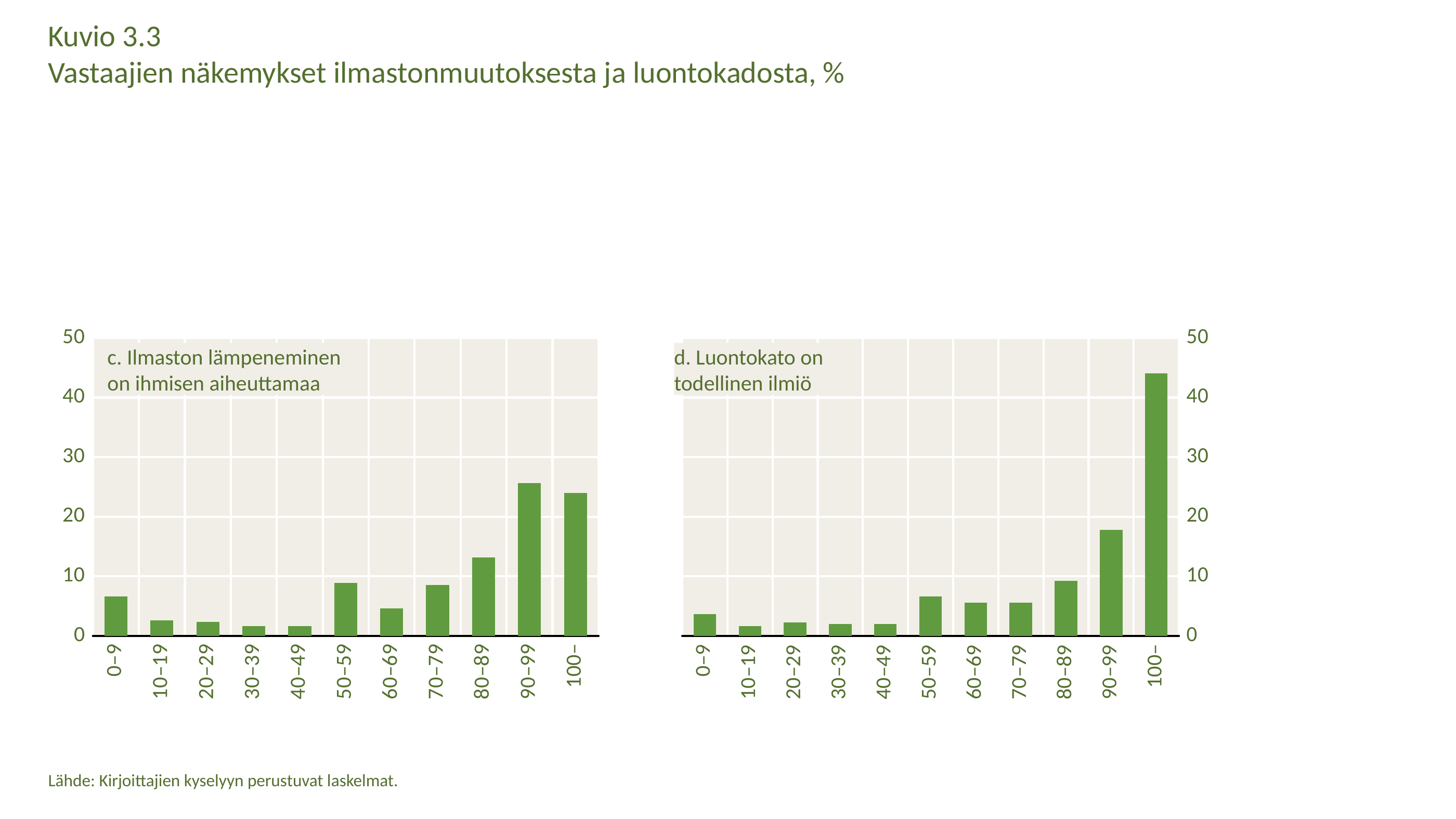
Which is larger: the value for 100– in panel c (Ilmaston lämpeneminen on ihmisen aiheuttamaa) or the value for 100– in panel d (Luontokato on todellinen ilmiö)? panel d (Luontokato on todellinen ilmiö) In panel d (Luontokato on todellinen ilmiö), which category has the highest value? 100– What is the maximum value shown on the y axis of panel d (Luontokato on todellinen ilmiö)? 50 In panel c (Ilmaston lämpeneminen on ihmisen aiheuttamaa), is the value for 80–89 greater or less than 10? greater What kind of chart is used in panel c (Ilmaston lämpeneminen on ihmisen aiheuttamaa)? bar chart In panel d (Luontokato on todellinen ilmiö), is the value for 100– greater or less than 40? greater What is the title of the figure on the slide? Vastaajien näkemykset ilmastonmuutoksesta ja luontokadosta, % In panel c (Ilmaston lämpeneminen on ihmisen aiheuttamaa), which is larger: the value for 50–59 or the value for 60–69? 50–59 In panel c (Ilmaston lämpeneminen on ihmisen aiheuttamaa), is the value for 90–99 greater or less than 20? greater How many categories are shown on the x axis of panel c (Ilmaston lämpeneminen on ihmisen aiheuttamaa)? 11